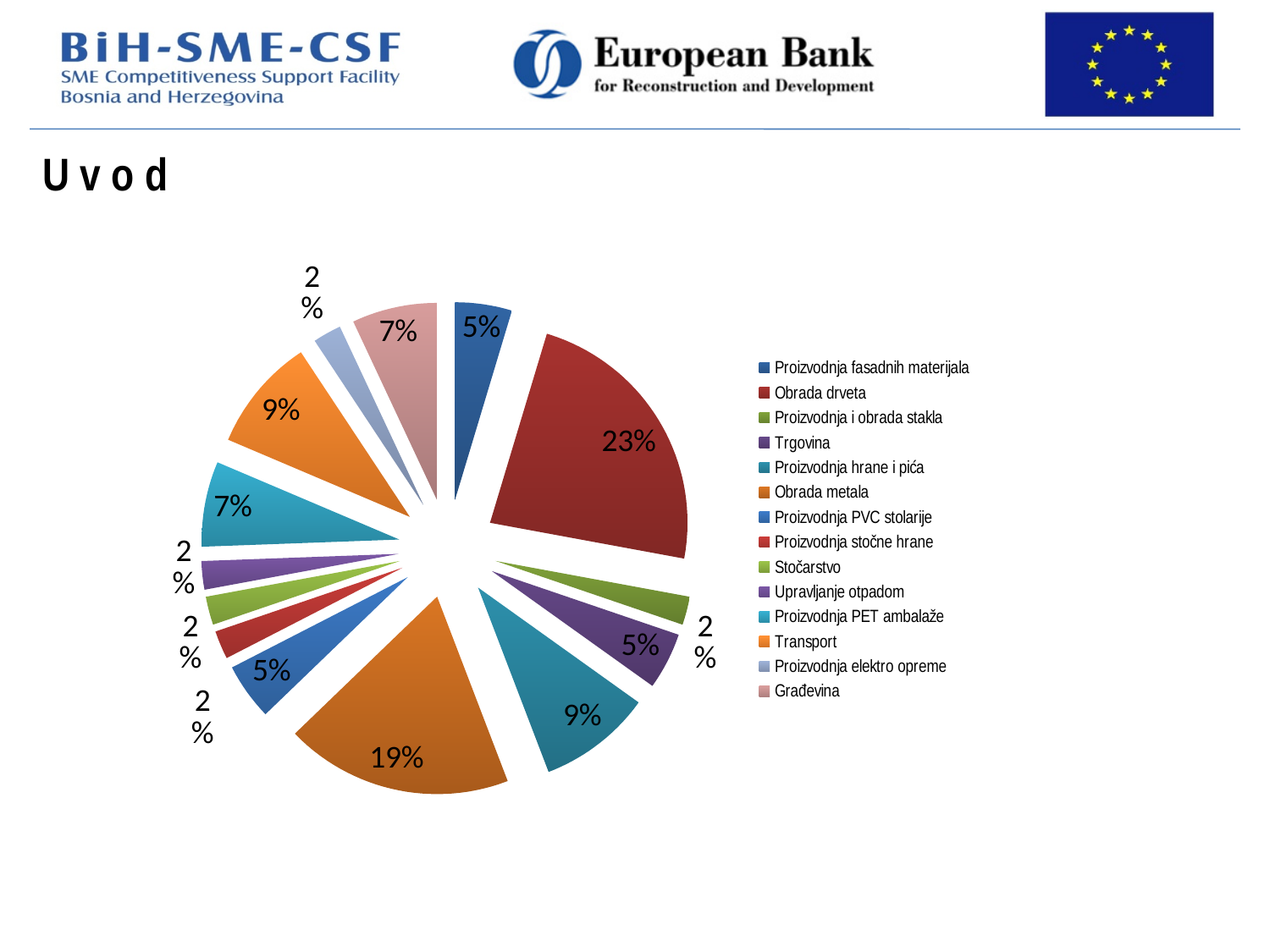
What share of the pie does Obrada drveta have? 23% Which has the larger share, Transport or Građevina? Transport Which category has the largest share of the pie? Obrada drveta What share of the pie does Proizvodnja fasadnih materijala have? 5% What share of the pie does Proizvodnja hrane i pića have? 9% What share of the pie does Građevina have? 7% What share of the pie does Obrada metala have? 19% What kind of chart is shown on the slide? pie chart How many categories does the legend list? 14 What is the title of the slide containing the pie chart? Uvod What is the difference in percentage points between the shares of Obrada drveta and Obrada metala? 4 percentage points What share of the pie does Transport have? 9%